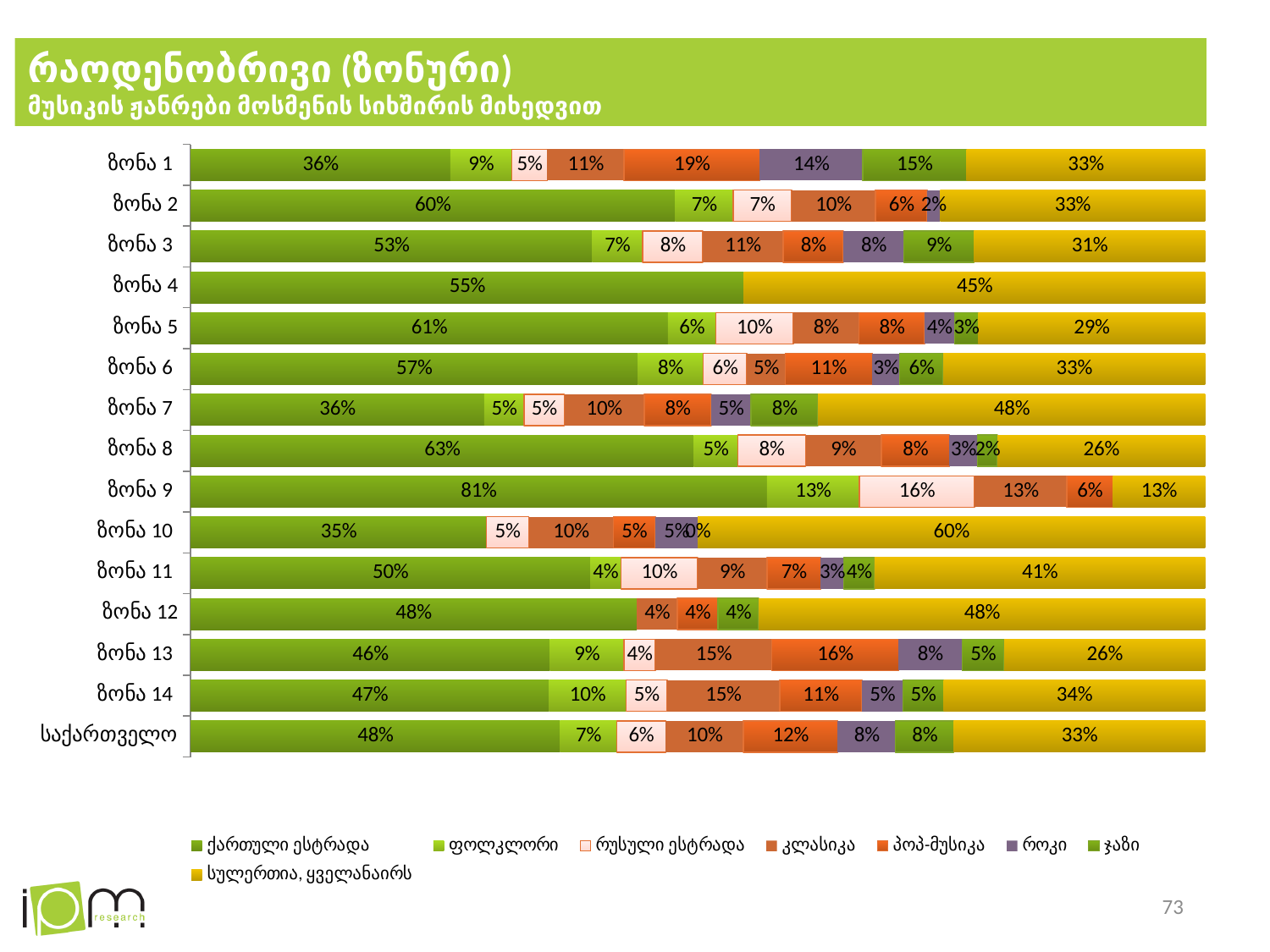
What is the value of პოპ-მუსიკა for ზონა 1? 19% Which category has the highest value for სულერთია, ყველანაირს? ზონა 10 What is the value of ქართული ესტრადა for ზონა 9? 81% Which category has the highest value for ქართული ესტრადა? ზონა 9 For ზონა 4, what is the difference between ქართული ესტრადა (55%) and სულერთია, ყველანაირს (45%)? 10 percentage points What is the value of ქართული ესტრადა for საქართველო? 48% How many categories (bars) are plotted on the chart? 15 Which is larger: ქართული ესტრადა for ზონა 1 or for ზონა 2? ზონა 2 Which category has the lowest value for სულერთია, ყველანაირს? ზონა 9 What is the value of სულერთია, ყველანაირს for ზონა 10? 60% What type of chart is shown on the slide? Stacked bar chart How many series does the legend list? 8